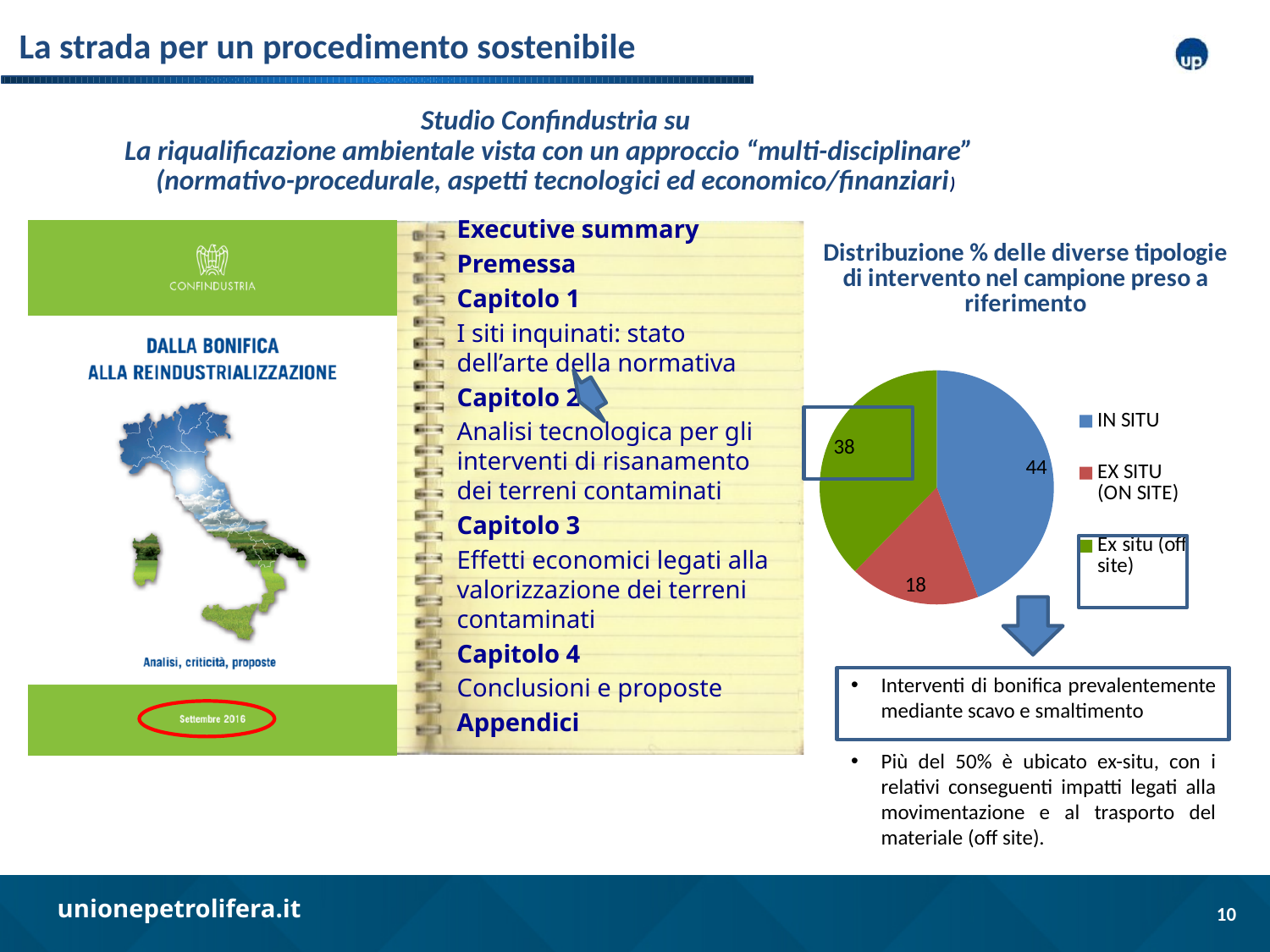
What kind of chart is shown on the slide? Pie chart What is the value for EX SITU (ON SITE) in the pie chart? 18 What is the difference between the IN SITU value and the Ex situ (off site) value? 6 Which category has the largest slice in the pie chart? IN SITU What is the difference between the Ex situ (off site) value and the EX SITU (ON SITE) value? 20 Which category has the smallest slice in the pie chart? EX SITU (ON SITE) What is the value for IN SITU in the pie chart? 44 How many entries does the legend of the pie chart list? 3 Which is larger, the IN SITU slice or the EX SITU (ON SITE) slice? IN SITU What is the value for Ex situ (off site) in the pie chart? 38 How many slices does the pie chart have? 3 What is the title of the pie chart? Distribuzione % delle diverse tipologie di intervento nel campione preso a riferimento